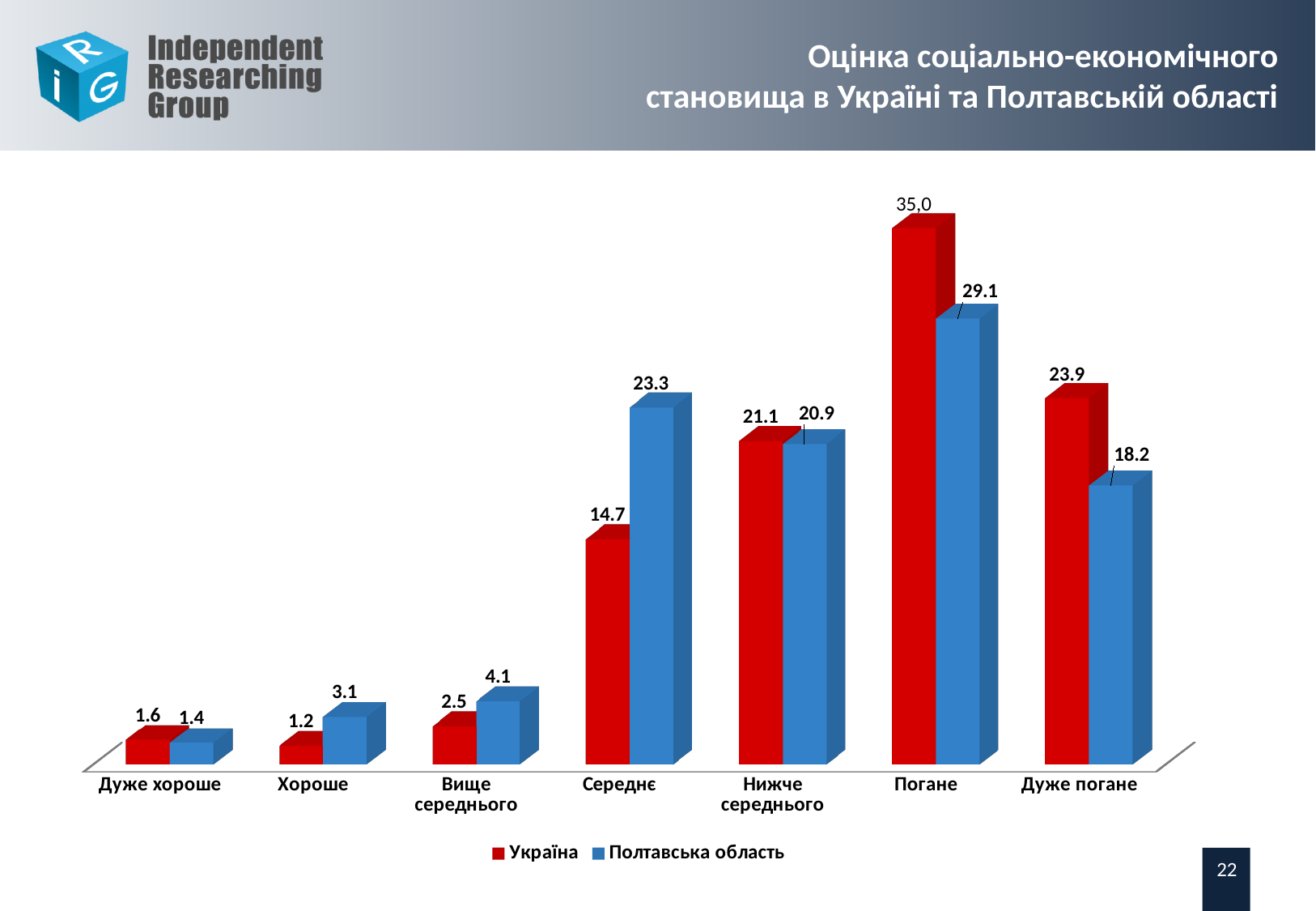
In the Вище середнього category, which series has the larger value, Україна or Полтавська область? Полтавська область How many series does the legend list? 2 What is the value for Україна in the Дуже погане category? 23.9 Which category has the lowest value for Україна? Хороше What is the value for Україна in the Погане category? 35,0 What kind of chart is shown on the slide? Bar chart What is the value for Полтавська область in the Хороше category? 3.1 What is the value for Полтавська область in the Середнє category? 23.3 What is the difference between the Україна and Полтавська область values in the Дуже погане category? 5.7 How many categories are shown on the x axis? 7 What is the difference between the Україна and Полтавська область values in the Середнє category? 8.6 Which category has the highest value for Полтавська область? Погане